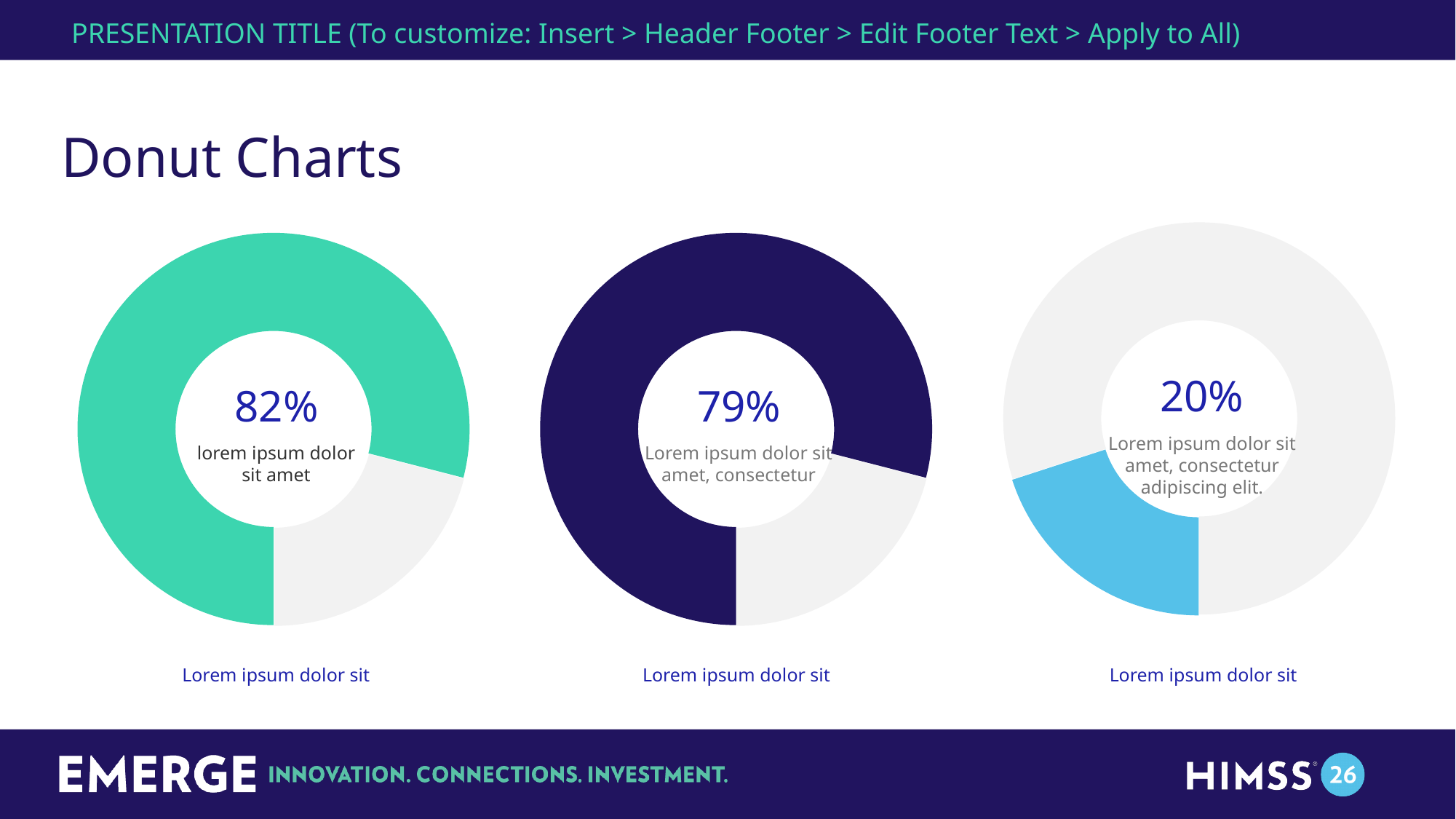
What colour is the filled segment of the right donut chart? light blue Which of the three donut charts shows the lowest percentage: left, middle or right? right Which of the three donut charts shows the highest percentage: left, middle or right? left Is the percentage shown in the right donut chart greater or less than 50%? less What is the difference between the percentage in the left donut chart and the percentage in the right donut chart? 62% How many donut charts are on the slide? 3 What kind of chart is used on this slide? donut chart What is the difference between the percentage in the left donut chart and the percentage in the middle donut chart? 3% Which is larger, the percentage in the middle donut chart or the percentage in the right donut chart? middle donut chart What percentage is shown in the centre of the left donut chart? 82% What percentage is shown in the centre of the right donut chart? 20% What percentage is shown in the centre of the middle donut chart? 79%